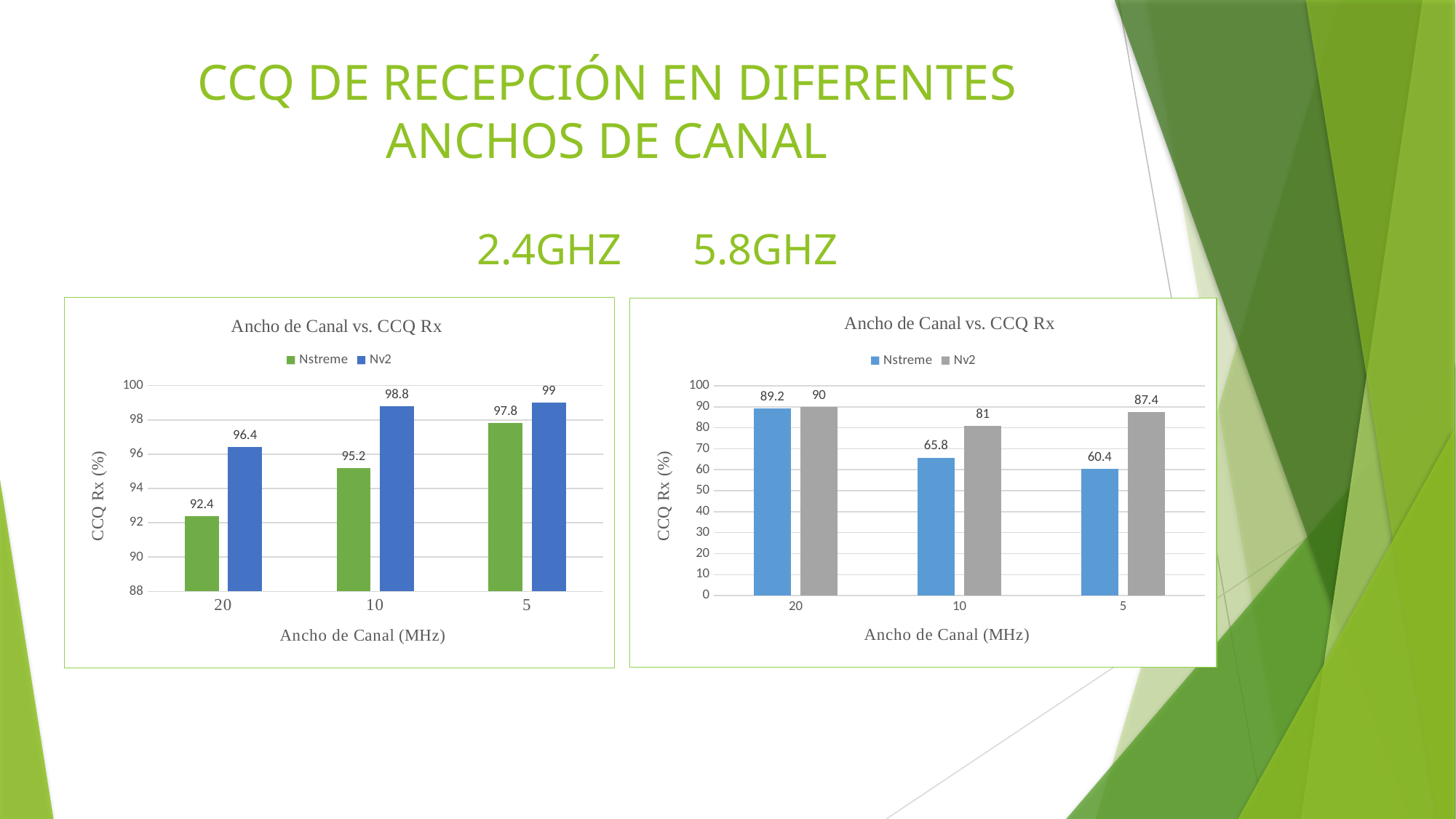
In the right chart (5.8GHZ), do the Nstreme values rise or fall from 20 MHz to 5 MHz along the x axis? fall In the right chart (5.8GHZ), what is the Nstreme value at 5 MHz? 60.4 In the left chart (2.4GHZ), at which channel width is the Nv2 value highest? 5 In the left chart (2.4GHZ), what is the difference between the Nv2 and Nstreme values at 20 MHz? 4 In the right chart (5.8GHZ), which is larger at 10 MHz, Nstreme or Nv2? Nv2 What kind of chart is the right chart (5.8GHZ)? bar chart In the left chart (2.4GHZ), what is the Nv2 value at 10 MHz? 98.8 In the right chart (5.8GHZ), what is the difference between the Nv2 and Nstreme values at 5 MHz? 27 In the left chart (2.4GHZ), what is the Nstreme value at 20 MHz? 92.4 In the right chart (5.8GHZ), what is the Nv2 value at 10 MHz? 81 How many series does the legend of the left chart (2.4GHZ) list? 2 In the right chart (5.8GHZ), at which channel width is the Nstreme value lowest? 5